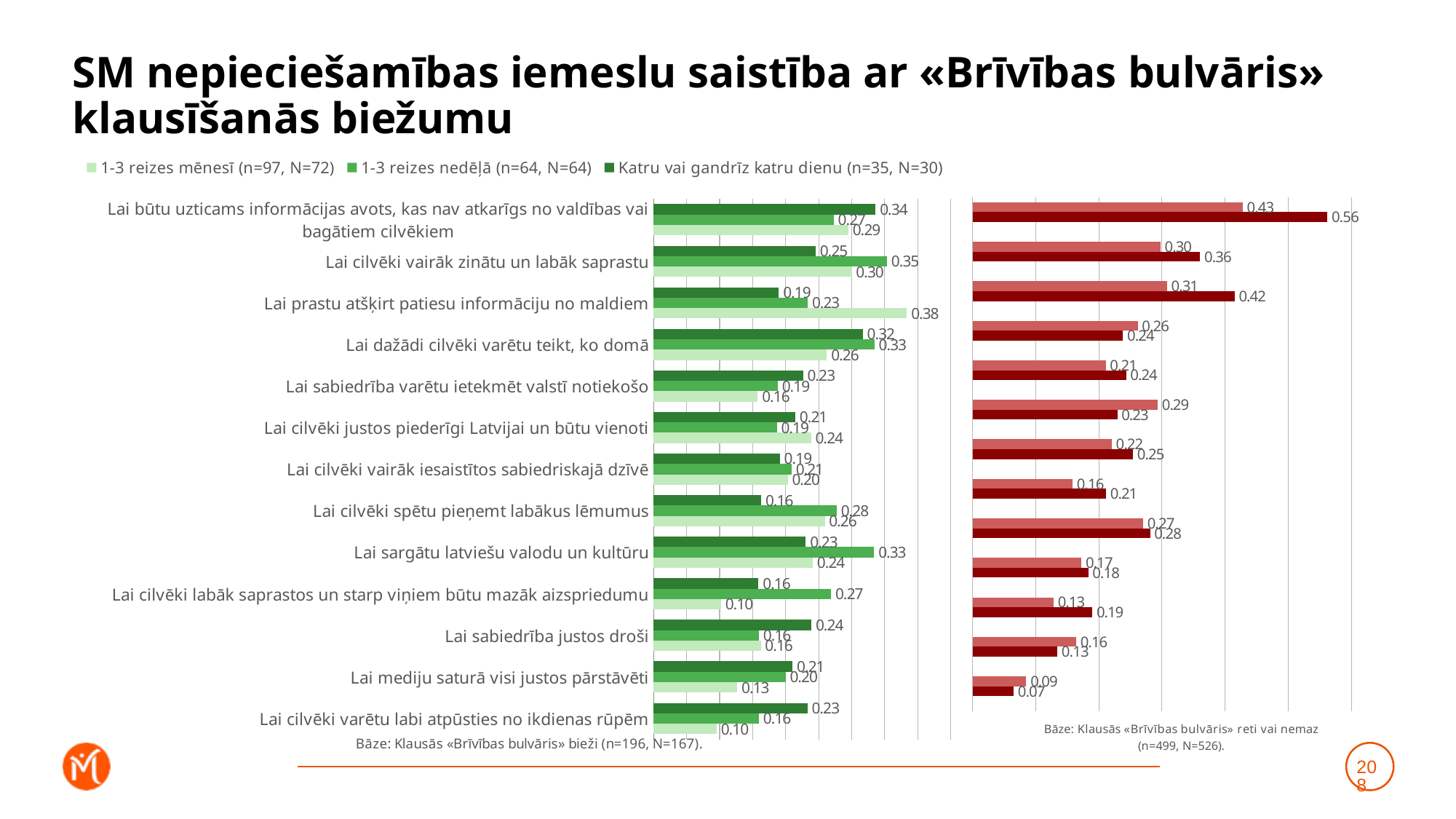
What kind of chart is the left (green) chart? Bar chart In the left (green) chart, what is the value for '1-3 reizes mēnesī' for 'Lai prastu atšķirt patiesu informāciju no maldiem'? 0.38 In the right (red) chart, what is the value of the lighter red bar for 'Lai cilvēki varētu labi atpūsties no ikdienas rūpēm'? 0.09 In the left (green) chart, which category has the highest value for 'Katru vai gandrīz katru dienu'? Lai būtu uzticams informācijas avots, kas nav atkarīgs no valdības vai bagātiem cilvēkiem In the right (red) chart, what is the value of the darker red bar for 'Lai būtu uzticams informācijas avots, kas nav atkarīgs no valdības vai bagātiem cilvēkiem'? 0.56 In the left (green) chart, what is the value for '1-3 reizes nedēļā' for 'Lai sargātu latviešu valodu un kultūru'? 0.33 In the left (green) chart, for 'Lai cilvēki labāk saprastos un starp viņiem būtu mazāk aizspriedumu', which is larger: '1-3 reizes nedēļā' or '1-3 reizes mēnesī'? 1-3 reizes nedēļā In the left (green) chart, what is the value for 'Katru vai gandrīz katru dienu' for 'Lai būtu uzticams informācijas avots, kas nav atkarīgs no valdības vai bagātiem cilvēkiem'? 0.34 In the left (green) chart, what is the difference between the '1-3 reizes nedēļā' and 'Katru vai gandrīz katru dienu' values for 'Lai cilvēki spētu pieņemt labākus lēmumus'? 0.12 How many categories are shown in the left (green) chart? 13 How many series does the legend of the left (green) chart list? 3